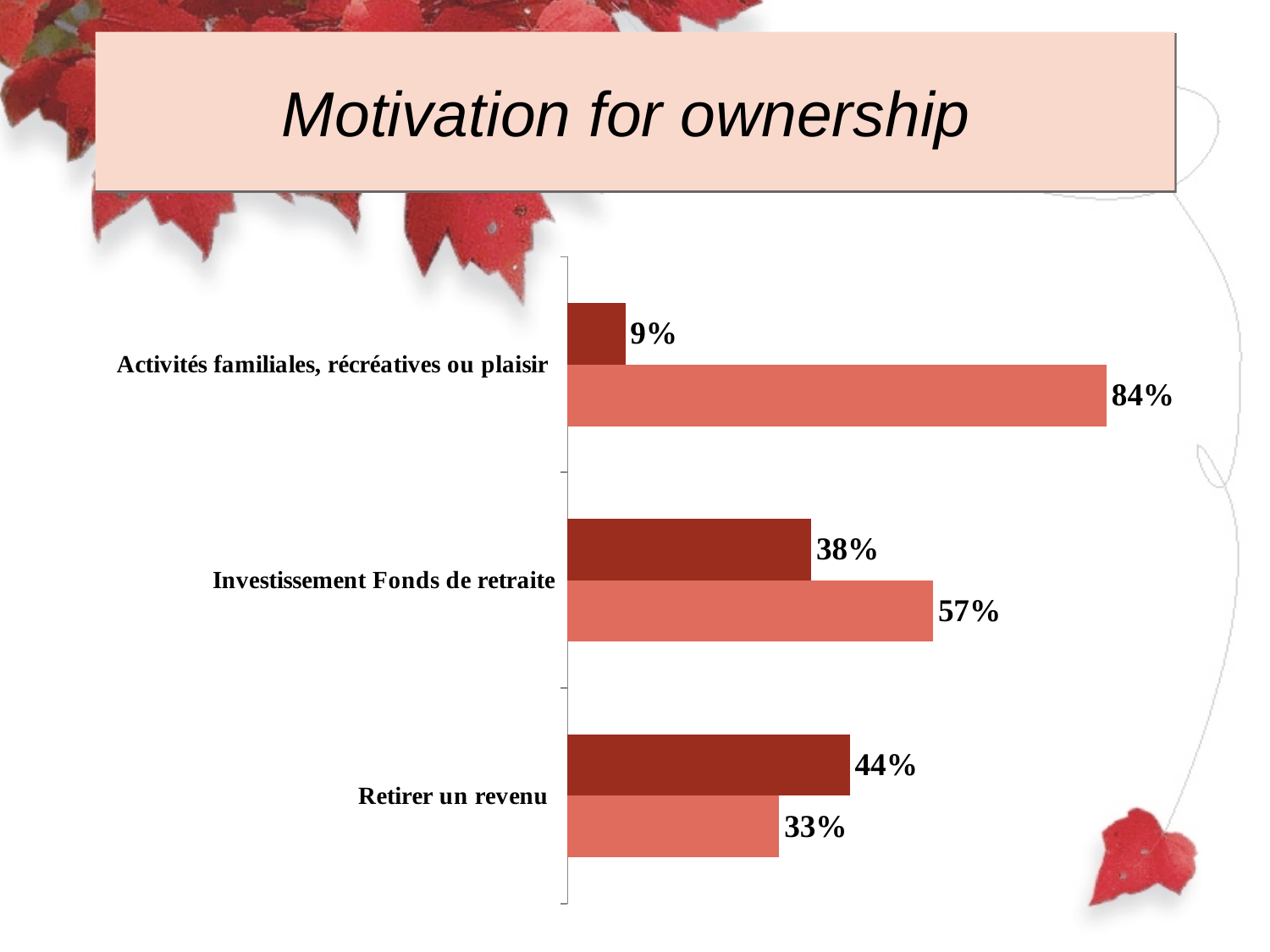
What type of chart is shown on the slide? bar chart How many categories are shown on the chart? 3 What is the value of the dark red bar for "Investissement Fonds de retraite"? 38% What is the difference between the light red and dark red bars for "Investissement Fonds de retraite"? 19% What is the value of the light red bar for "Activités familiales, récréatives ou plaisir"? 84% What is the difference between the light red bar and the dark red bar for "Activités familiales, récréatives ou plaisir"? 75% What is the value of the dark red bar for "Activités familiales, récréatives ou plaisir"? 9% What is the value of the light red bar for "Retirer un revenu"? 33% What is the title of the slide containing the chart? Motivation for ownership Which category has the lowest value among the dark red bars? Activités familiales, récréatives ou plaisir For "Retirer un revenu", which bar is larger, the dark red or the light red? dark red Which category has the highest value among the light red bars? Activités familiales, récréatives ou plaisir